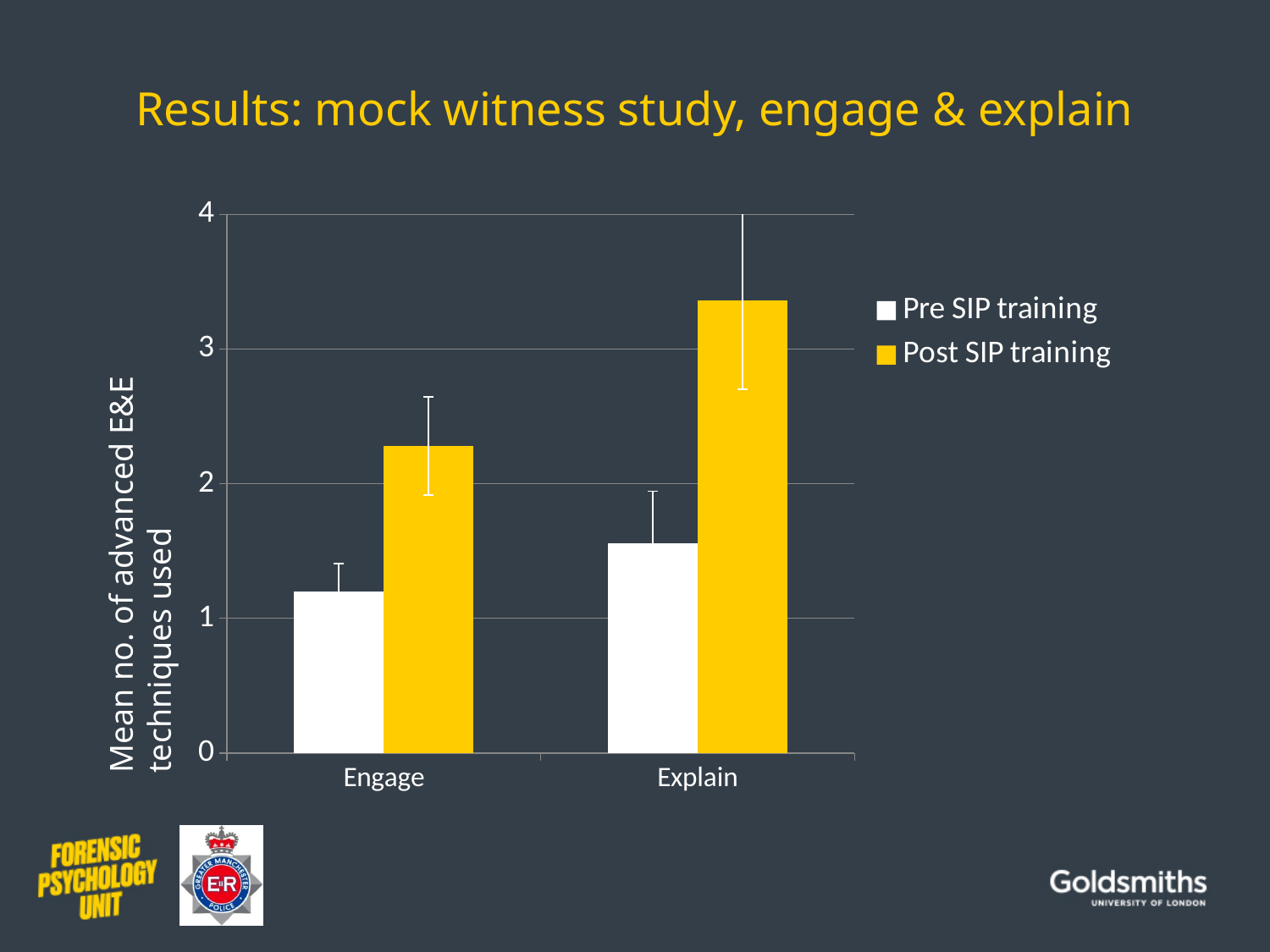
Which series and category has the highest bar in the chart? Post SIP training, Explain How many categories are shown on the x axis of the chart? 2 Which series and category has the lowest bar in the chart? Pre SIP training, Engage What is the label on the y axis of the chart? Mean no. of advanced E&E techniques used Is the Pre SIP training value for Explain greater or less than 2? less Which colour represents the Post SIP training series in the chart? Yellow For the Engage category, which is larger: the Pre SIP training bar or the Post SIP training bar? Post SIP training Is the Post SIP training value for Explain greater or less than 3? greater For the Post SIP training series, which category has the larger bar: Engage or Explain? Explain What kind of chart is shown on the slide? Bar chart Is the Post SIP training value for Engage greater or less than 2? greater How many series does the chart's legend list? 2